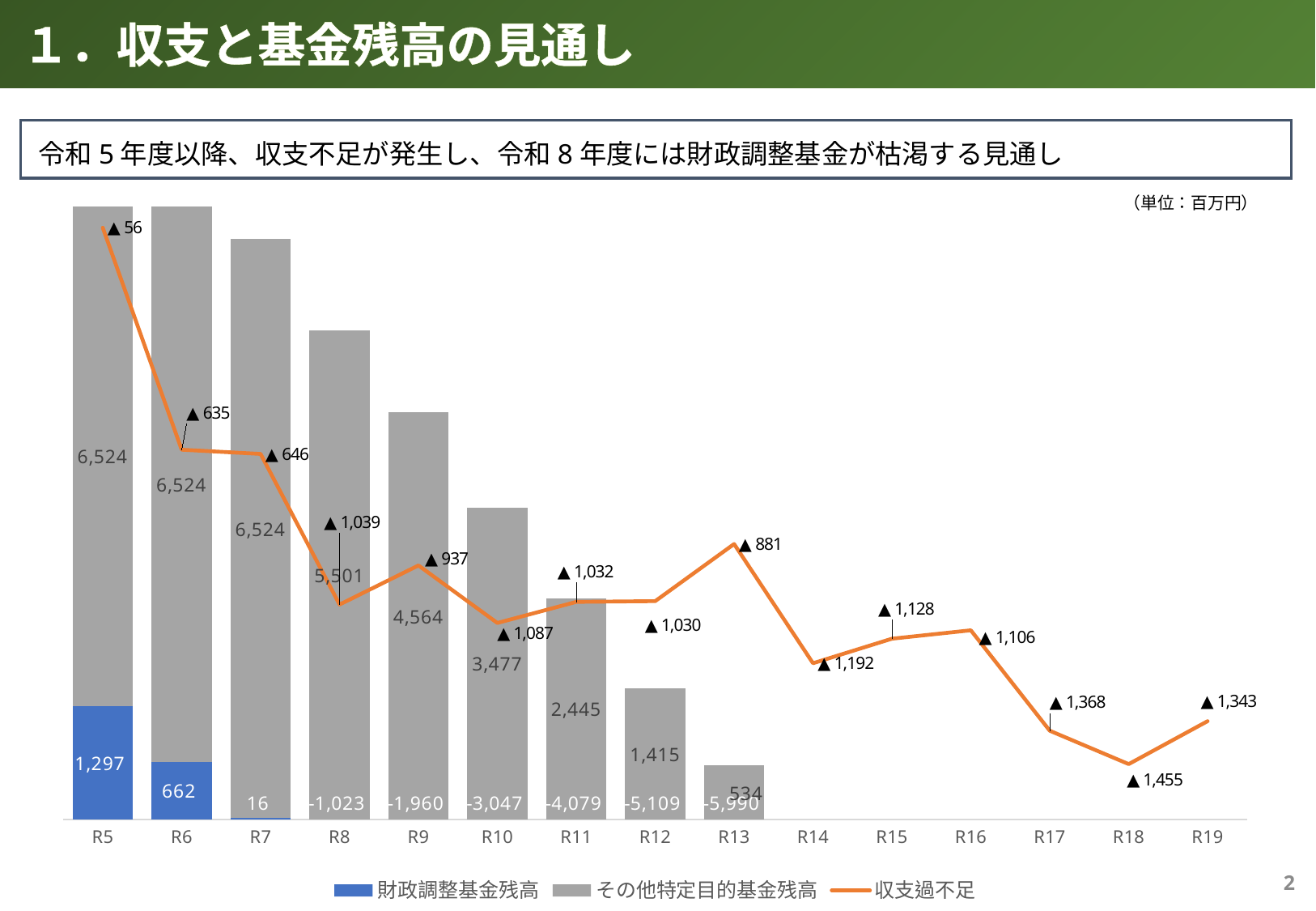
Which is larger, the 財政調整基金残高 value for R5 or for R6? R5 What kind of chart is this? Combined bar and line chart Which category has the lowest その他特定目的基金残高 value among the labelled bars? R13 How many series does the legend list? 3 What is the value of その他特定目的基金残高 for R9? 4,564 What is the difference between the その他特定目的基金残高 values for R8 and R9? 937 What is the value of 財政調整基金残高 for R5? 1,297 How many categories are shown on the x axis? 15 What is the 収支過不足 value shown for R18? ▲ 1,455 What is the 収支過不足 value shown for R13? ▲ 881 What unit is stated for the chart values? 百万円 Which category has the highest 財政調整基金残高 value? R5